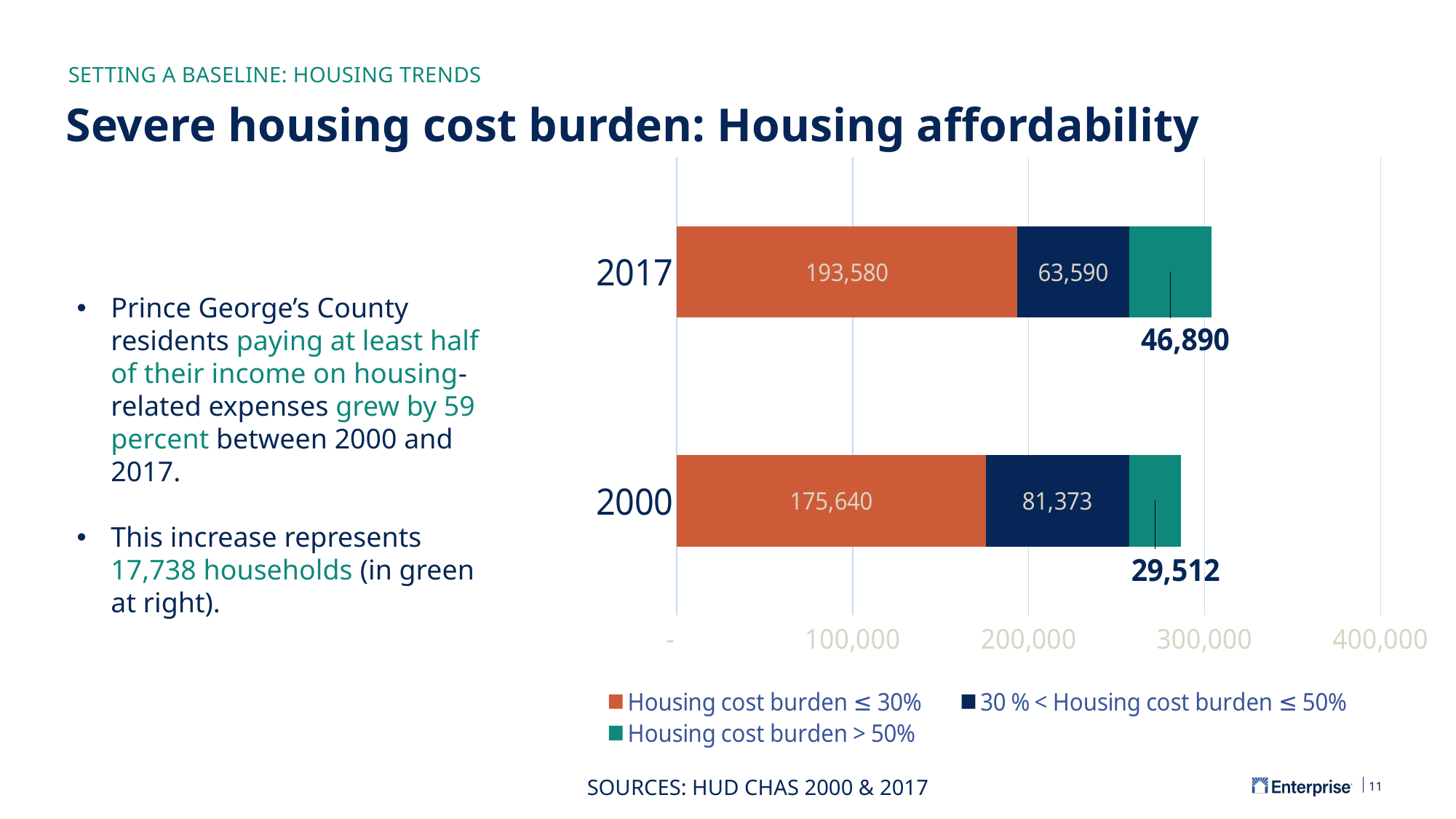
Which colour represents 'Housing cost burden > 50%' in the chart? Green What is the value for 'Housing cost burden > 50%' in 2000? 29,512 What is the value for '30 % < Housing cost burden ≤ 50%' in 2000? 81,373 What is the value for 'Housing cost burden > 50%' in 2017? 46,890 What is the value for 'Housing cost burden ≤ 30%' in 2017? 193,580 How many years (categories) are plotted in the chart? 2 What is the difference between the 'Housing cost burden ≤ 30%' values for 2017 and 2000? 17,940 Which year has the larger value for '30 % < Housing cost burden ≤ 50%', 2000 or 2017? 2000 How many series does the chart legend list? 3 What type of chart is shown on the slide? Stacked bar chart Is the total of the stacked bar for 2000 greater or less than 300,000? less What is the total of the stacked bar for 2017? 304,060